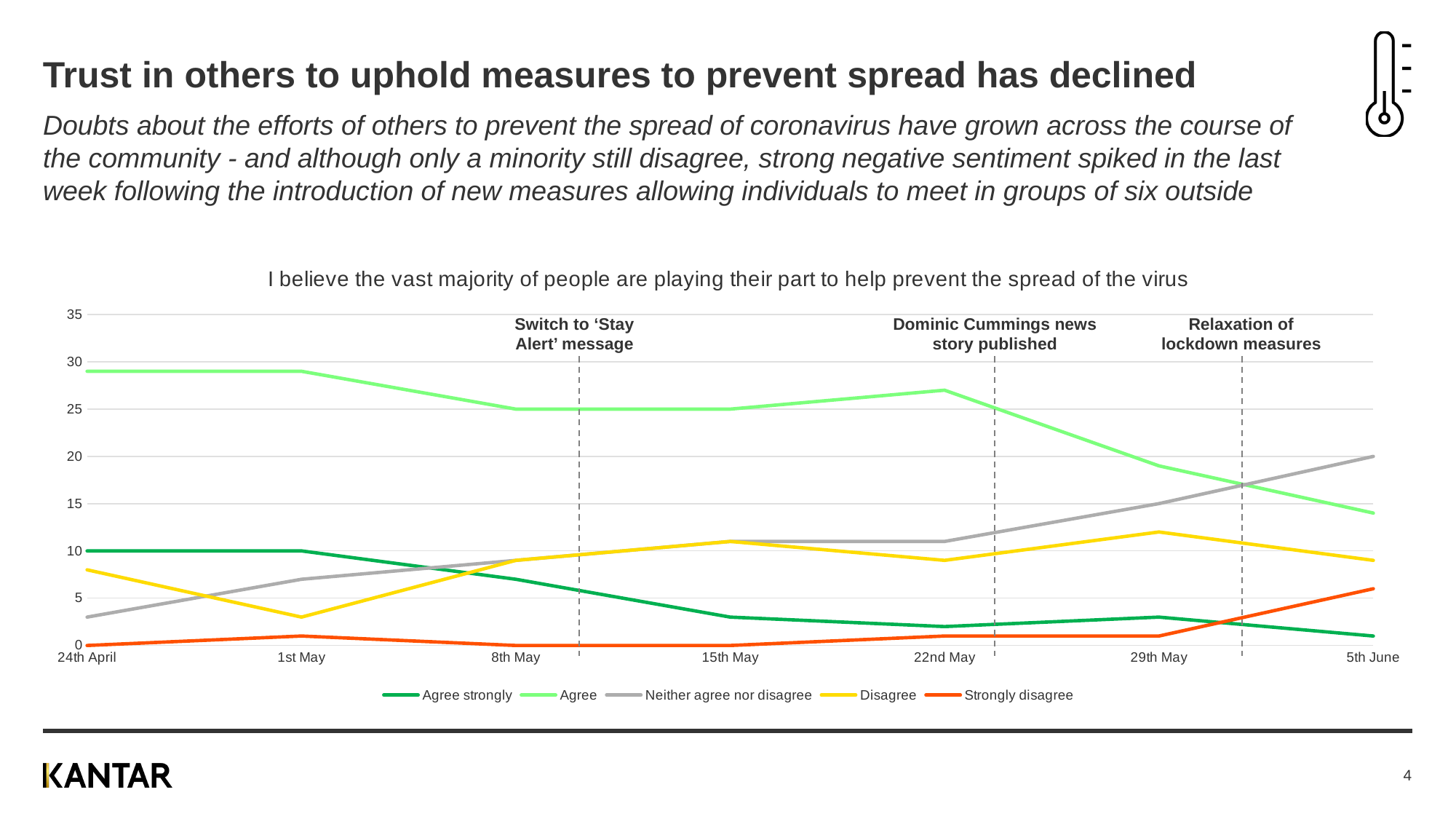
Which series has the highest value on 24th April? Agree What is the value for Agree strongly on 24th April? 10 What is the value for Neither agree nor disagree on 5th June? 20 How many series does the legend list? 5 What kind of chart is shown on the slide? Line chart How many dates are shown along the x axis? 7 Which series has the highest value on 5th June? Neither agree nor disagree What is the value for Agree on 8th May? 25 Which series has the lowest value on 24th April? Strongly disagree Does the Agree line rise or fall from 24th April to 5th June? Fall What event is annotated between 8th May and 15th May? Switch to 'Stay Alert' message Is the value for Agree on 22nd May greater or less than 25? greater